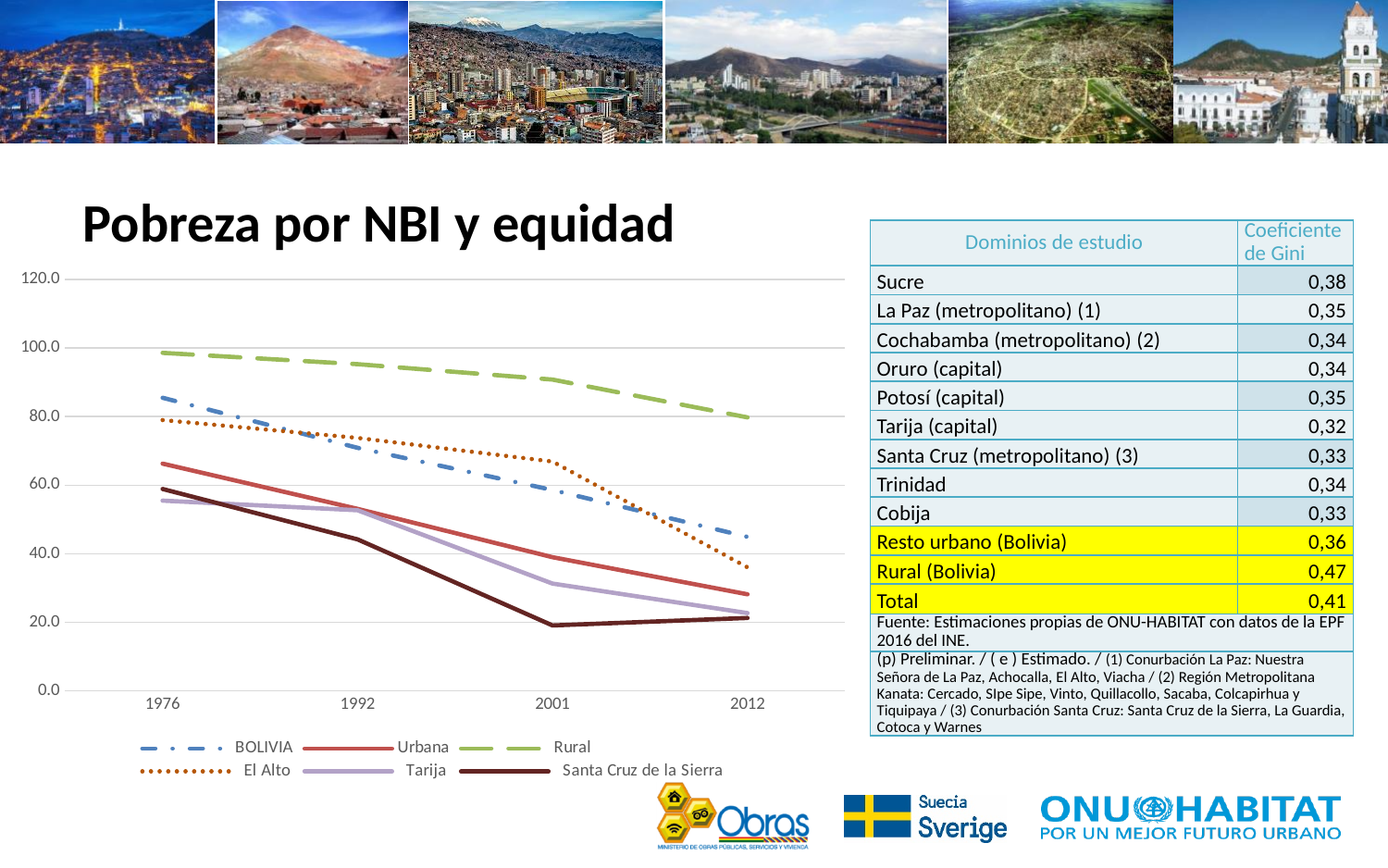
What kind of chart is shown on the slide? line chart Which is larger in 2012, the value for Rural or the value for Urbana? Rural Is the value for Rural in 1976 greater or less than 100? less What is the title of the slide containing the chart? Pobreza por NBI y equidad Which series has the lowest value in 2001? Santa Cruz de la Sierra Which series has the highest values across all years in the chart? Rural How many series does the chart legend list? 6 How many years are shown along the x axis of the chart? 4 Do the values for Urbana rise or fall from 1976 to 2012? fall Is the value for BOLIVIA in 1976 greater or less than 80? greater Is the value for El Alto in 2012 greater or less than 40? less